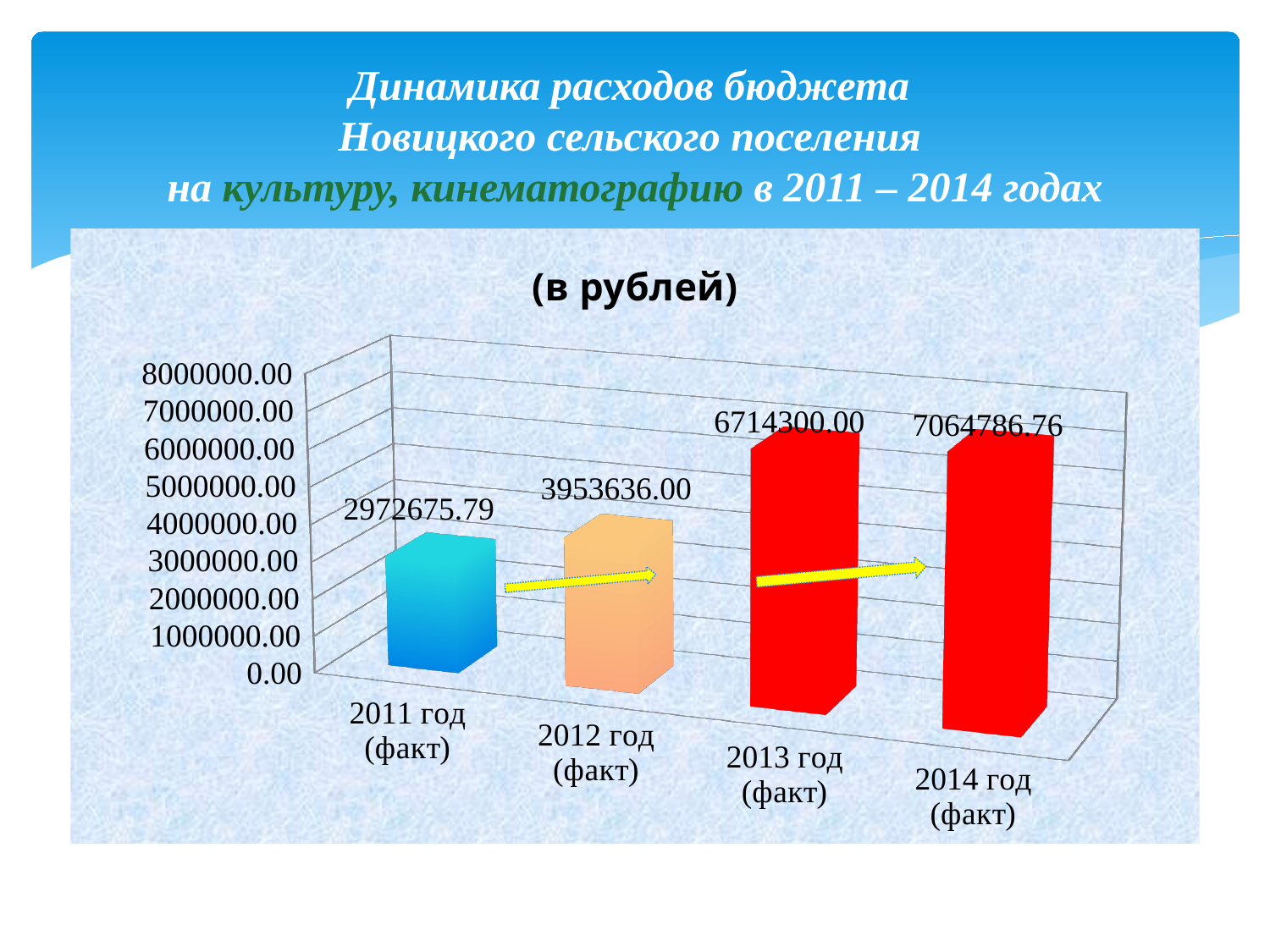
What is the value for 2012 год (факт)? 3953636.00 What kind of chart is shown on the slide? Bar chart What is the difference between the values for 2014 год (факт) and 2013 год (факт)? 350486.76 Which year has the highest value? 2014 год (факт) What is the value for 2013 год (факт)? 6714300.00 Which is larger, the value for 2012 год (факт) or 2013 год (факт)? 2013 год (факт) What is the difference between the values for 2012 год (факт) and 2011 год (факт)? 980960.21 What is the value for 2014 год (факт)? 7064786.76 Which year has the lowest value? 2011 год (факт) Do the values rise or fall from 2011 to 2014? Rise How many categories are shown on the chart? 4 What is the value for 2011 год (факт)? 2972675.79